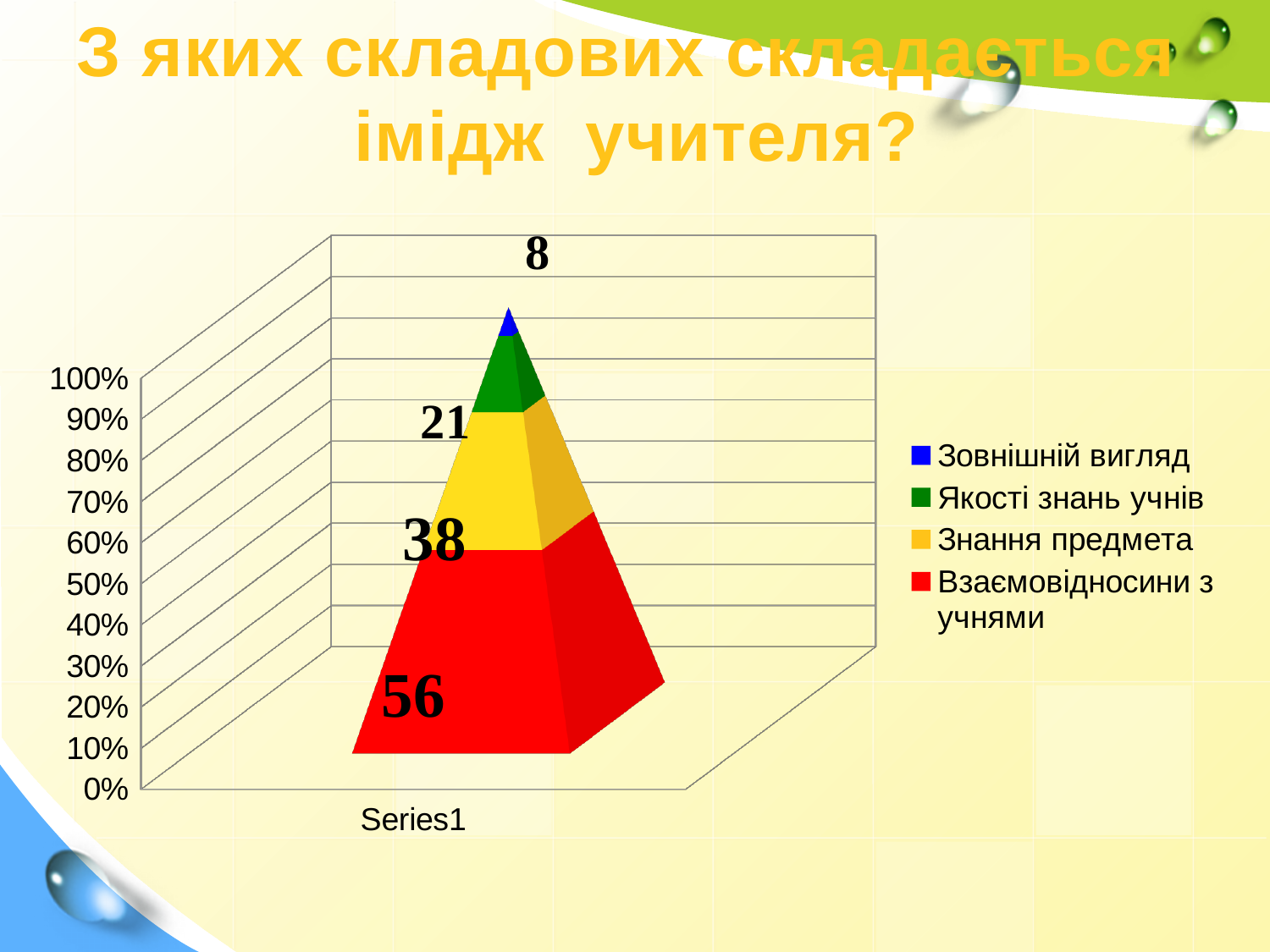
What value is shown for Знання предмета? 38 What is the difference between the values for Взаємовідносини з учнями and Знання предмета? 18 How many series does the legend list? 4 Which is larger, the value for Якості знань учнів or the value for Зовнішній вигляд? Якості знань учнів Which series has the smallest value? Зовнішній вигляд What colour represents Знання предмета in the chart? Yellow What value is shown for Взаємовідносини з учнями? 56 What is the category label shown on the x axis? Series1 What value is shown for Якості знань учнів? 21 What is the total of all the stacked values? 123 What value is shown for Зовнішній вигляд? 8 Which series has the largest value? Взаємовідносини з учнями